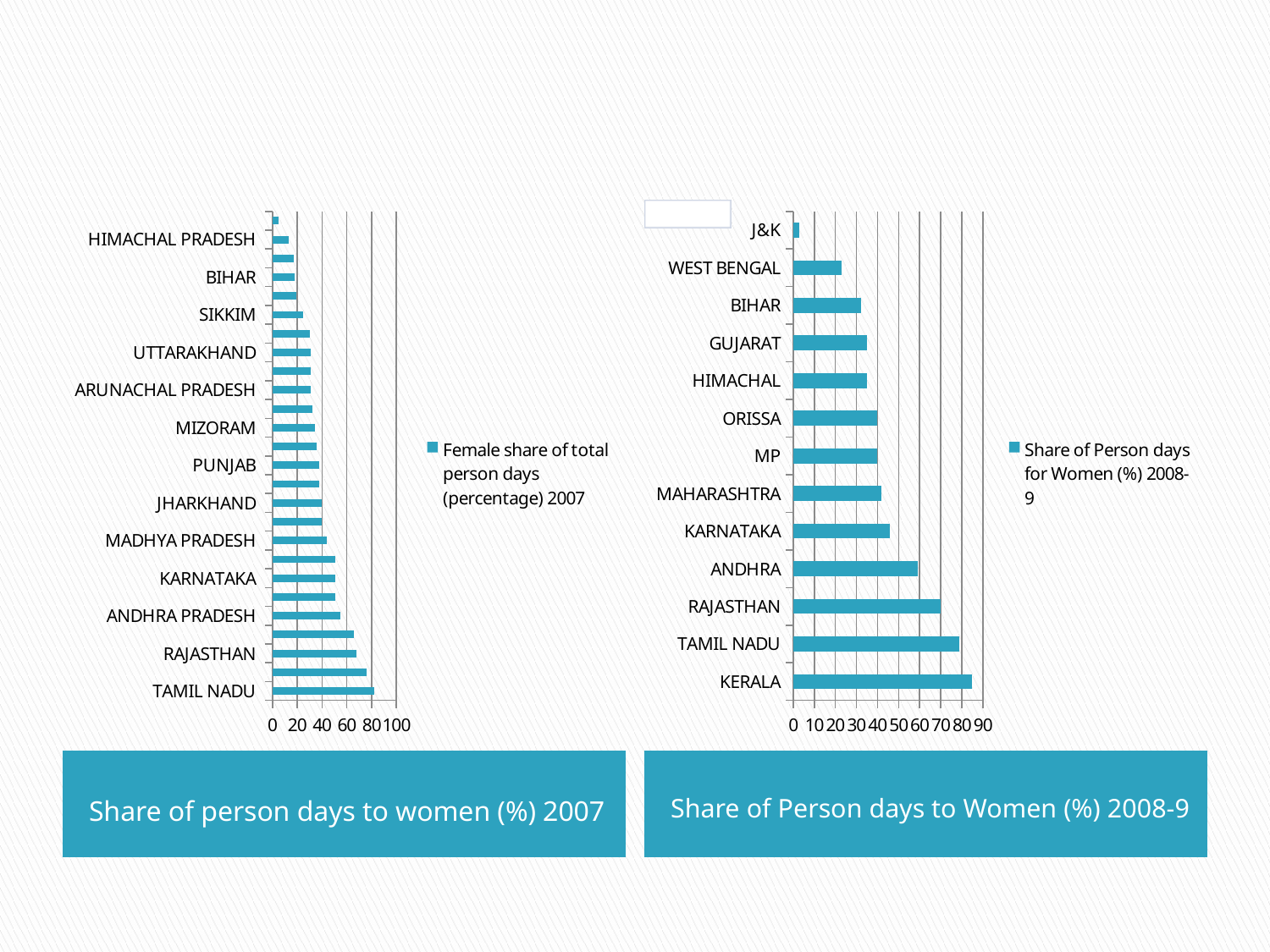
How many series does the legend of the 'Share of Person days to Women (%) 2008-9' chart on the right list? 1 How many states are shown in the 'Share of Person days to Women (%) 2008-9' chart on the right? 13 In the 'Share of person days to women (%) 2007' chart on the left, which labelled state has the highest value? Tamil Nadu What is the legend entry of the 'Share of person days to women (%) 2007' chart on the left? Female share of total person days (percentage) 2007 What kind of chart is the 'Share of person days to women (%) 2007' chart on the left? bar chart In the 'Share of Person days to Women (%) 2008-9' chart on the right, which is larger, the value for Rajasthan or the value for Maharashtra? Rajasthan In the 'Share of Person days to Women (%) 2008-9' chart on the right, which is larger, the value for Andhra or the value for Karnataka? Andhra In the 'Share of Person days to Women (%) 2008-9' chart on the right, which state has the highest value? Kerala In the 'Share of person days to women (%) 2007' chart on the left, is the value for Rajasthan greater or less than 60? greater In the 'Share of Person days to Women (%) 2008-9' chart on the right, which state has the lowest value? J&K In the 'Share of Person days to Women (%) 2008-9' chart on the right, is the value for West Bengal greater or less than 30? less In the 'Share of Person days to Women (%) 2008-9' chart on the right, is the value for Tamil Nadu greater or less than 70? greater